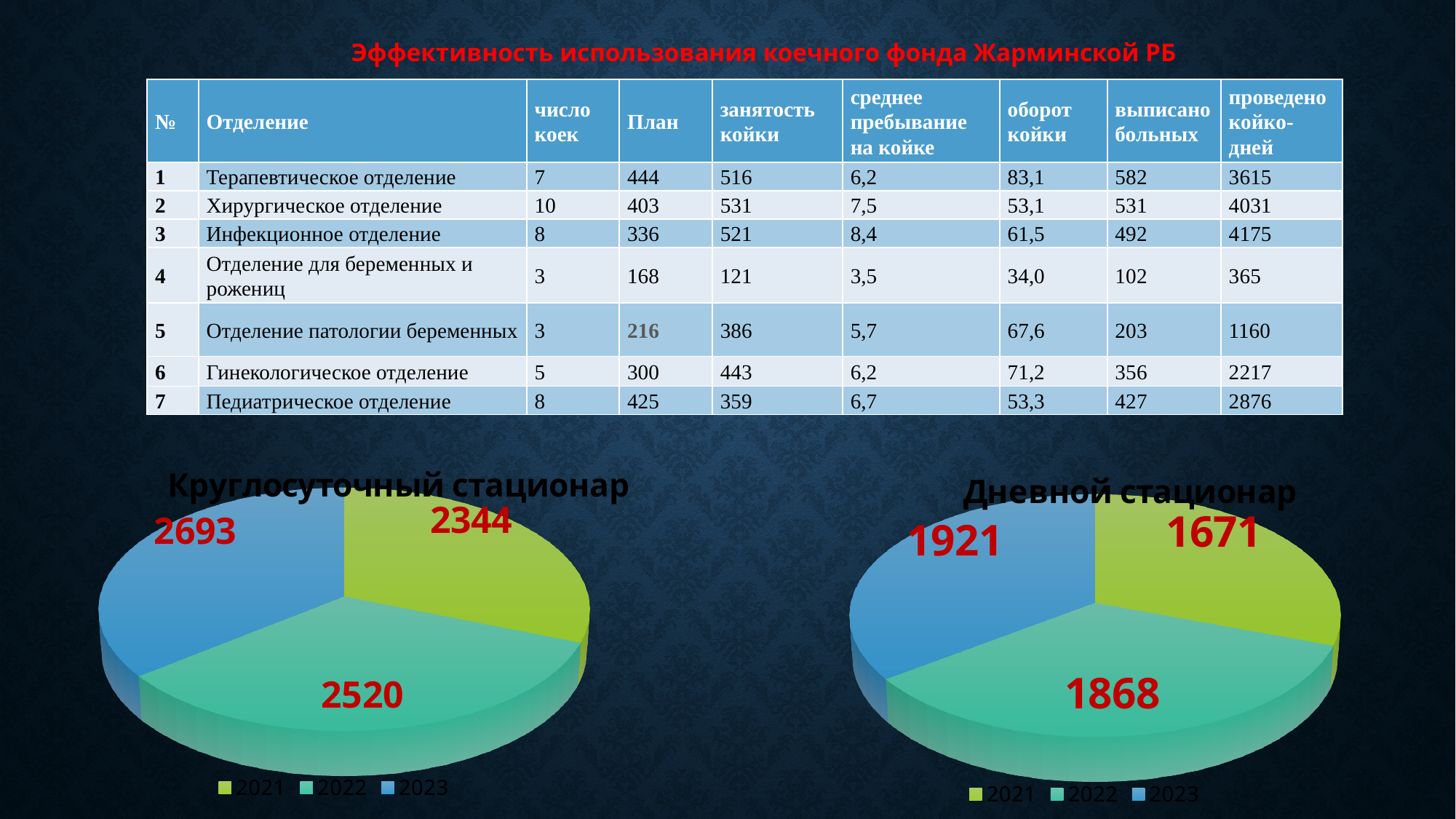
How many entries does the legend of the "Дневной стационар" chart list? 3 In the "Круглосуточный стационар" chart, what is the difference between the values for 2023 and 2021? 349 In the "Круглосуточный стационар" chart, which year has the lowest value? 2021 What type of chart is "Круглосуточный стационар"? pie chart In the "Круглосуточный стационар" chart, what is the value for 2023? 2693 In the "Дневной стационар" chart, which is larger, the value for 2022 or the value for 2021? 2022 In the "Дневной стационар" chart, what is the difference between the values for 2023 and 2021? 250 In the "Дневной стационар" chart, do the values rise or fall from 2021 to 2023? rise In the "Дневной стационар" chart, what is the value for 2022? 1868 How many slices does the "Круглосуточный стационар" pie chart have? 3 In the "Дневной стационар" chart, which year has the highest value? 2023 In the "Круглосуточный стационар" chart, what is the value for 2021? 2344